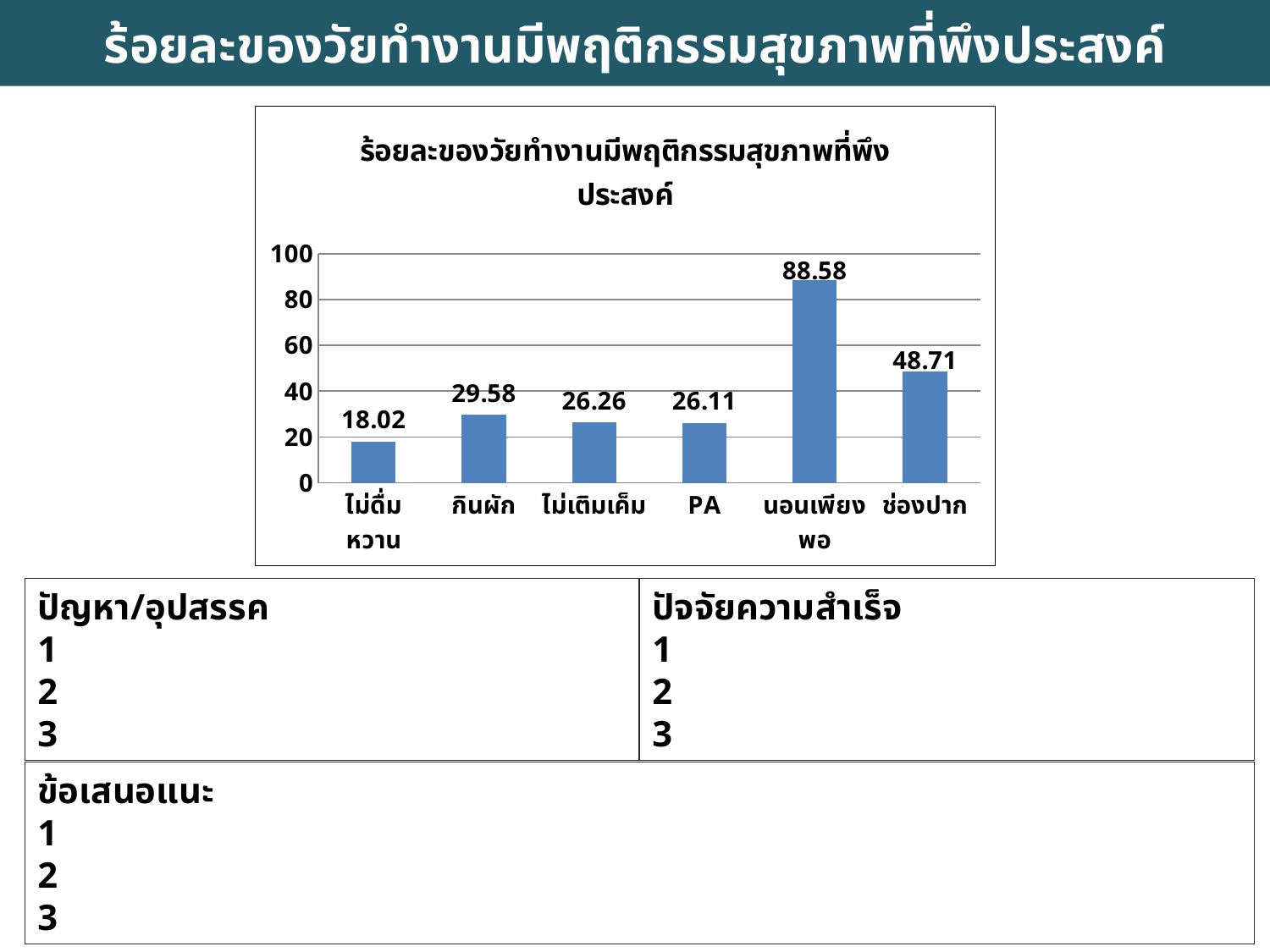
What is the title of the chart? ร้อยละของวัยทำงานมีพฤติกรรมสุขภาพที่พึงประสงค์ What is the value for ช่องปาก? 48.71 What is the value for ไม่ดื่มหวาน? 18.02 What is the difference between the values for นอนเพียงพอ and ช่องปาก? 39.87 What is the value for กินผัก? 29.58 How many categories are shown on the x axis? 6 Is the value for ช่องปาก greater or less than 40? greater What is the value for นอนเพียงพอ? 88.58 Which is larger, the value for กินผัก or the value for PA? กินผัก Which category has the lowest value? ไม่ดื่มหวาน Which category has the highest value? นอนเพียงพอ What kind of chart is shown on the slide? bar chart